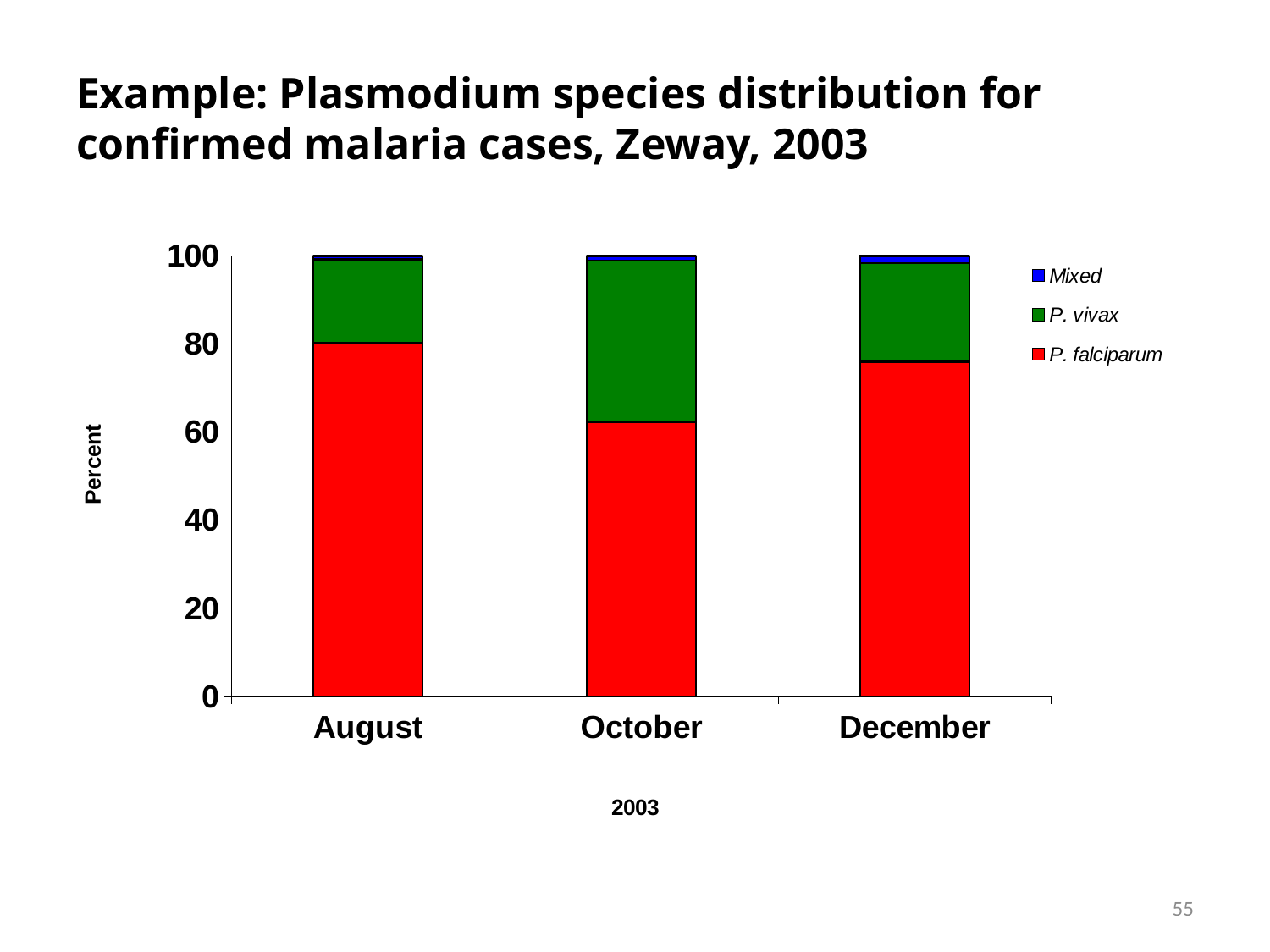
Is the P. vivax percentage larger in October or in December? October What is the label on the vertical axis of the chart? Percent Is the P. falciparum value for December greater or less than 80? less Is the P. falciparum value for August greater or less than 60? greater Which month has the lowest P. falciparum percentage? October How many series does the chart's legend list? 3 Which colour represents the Mixed series in the chart? blue Which month has the highest P. vivax percentage? October What kind of chart is shown on the slide? stacked bar chart Is the P. falciparum value for October greater or less than 80? less How many months are shown on the x axis of the chart? 3 Is the P. falciparum percentage higher in August or in October? August